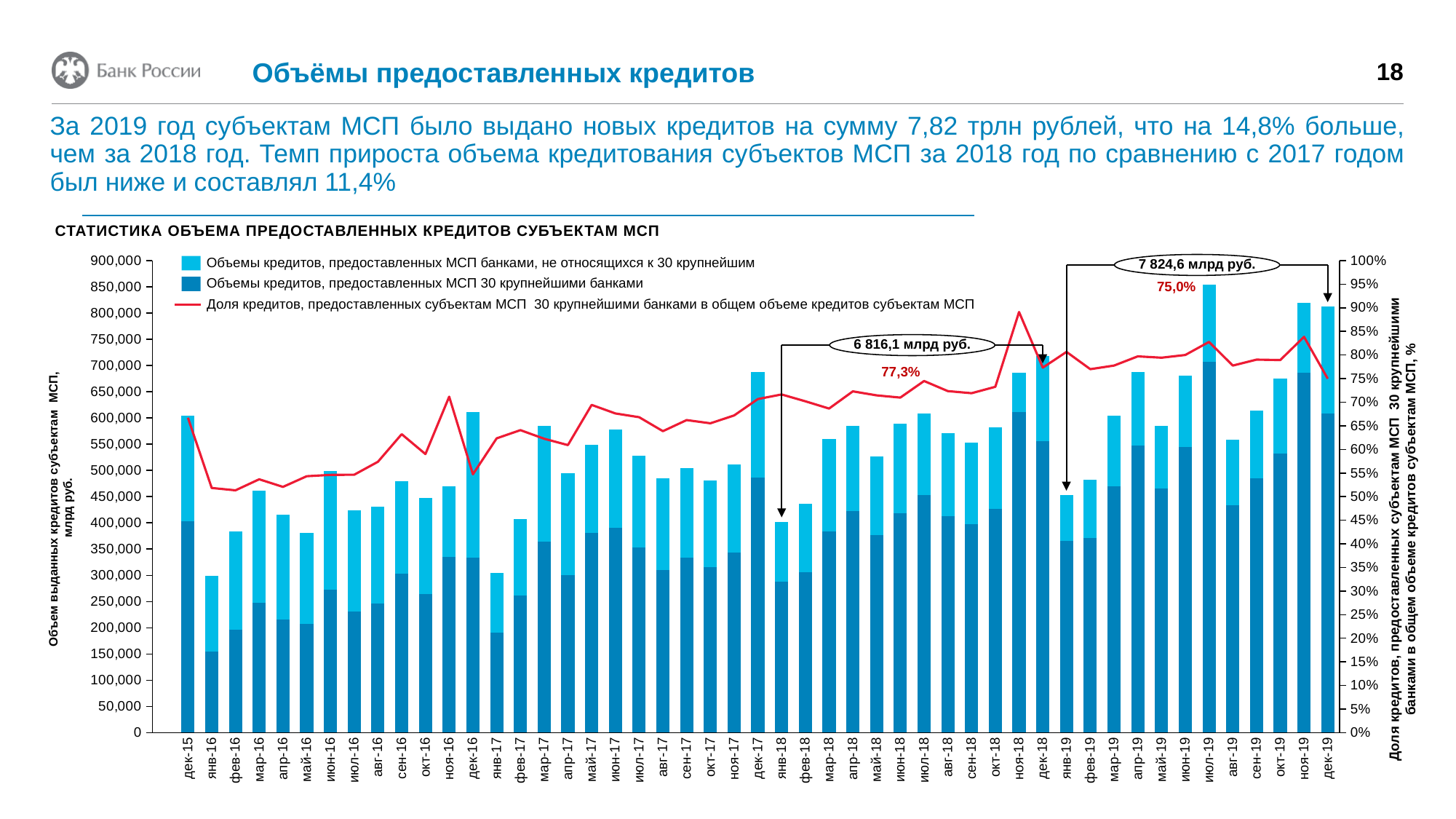
What annual loan volume is annotated on the chart for 2019 (the callout pointing to янв-19 and дек-19)? 7 824,6 млрд руб. Which month has the shortest stacked bar (smallest total loan volume)? янв-16 Is the total stacked bar for янв-16 greater or less than 350,000? less What share percentage is printed in red next to the 2018 annotation? 77,3% Which month has the tallest stacked bar (largest total loan volume)? июл-19 What kind of chart is shown on the slide? Stacked bar chart with a line What share percentage is printed in red next to the 2019 annotation? 75,0% What annual loan volume is annotated on the chart for 2018 (the callout pointing to янв-18 and дек-18)? 6 816,1 млрд руб. How many monthly categories are plotted along the x axis of the chart? 49 Is the total stacked bar for июл-19 greater or less than 800,000? greater How many series does the chart legend list? 3 What is the title of the chart on the slide? СТАТИСТИКА ОБЪЕМА ПРЕДОСТАВЛЕННЫХ КРЕДИТОВ СУБЪЕКТАМ МСП